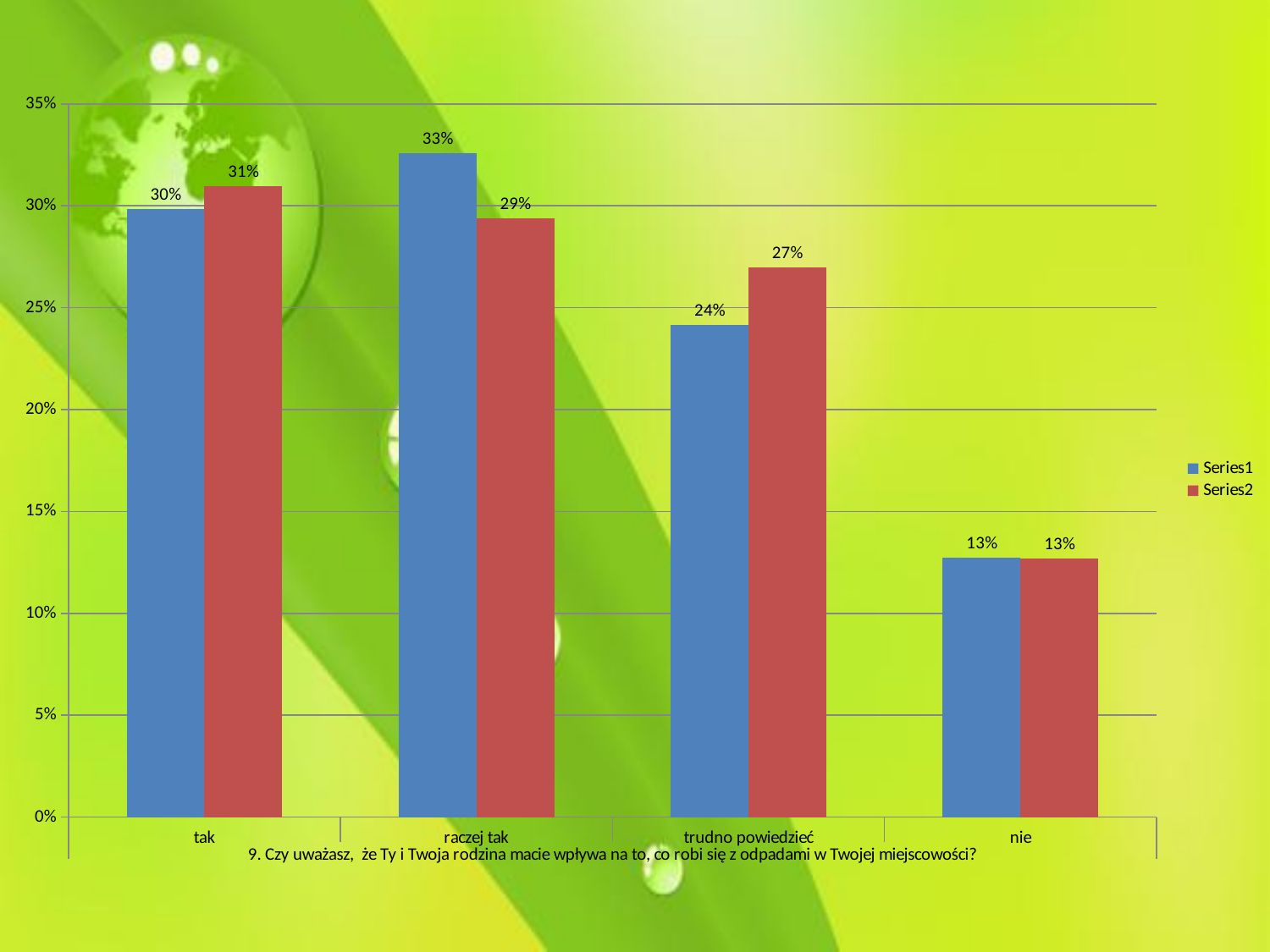
How many categories are shown on the x axis? 4 What is the difference between the Series1 and Series2 values for "raczej tak"? 4% What kind of chart is shown on the slide? bar chart Which category has the highest Series1 value? raczej tak What is the Series1 value for "tak"? 30% Which category has the lowest Series2 value? nie What is the Series1 value for "raczej tak"? 33% How many series does the legend list? 2 What is the Series2 value for "trudno powiedzieć"? 27% What colour are the Series2 bars? red What is the Series2 value for "nie"? 13% Which is larger for "trudno powiedzieć": Series1 or Series2? Series2